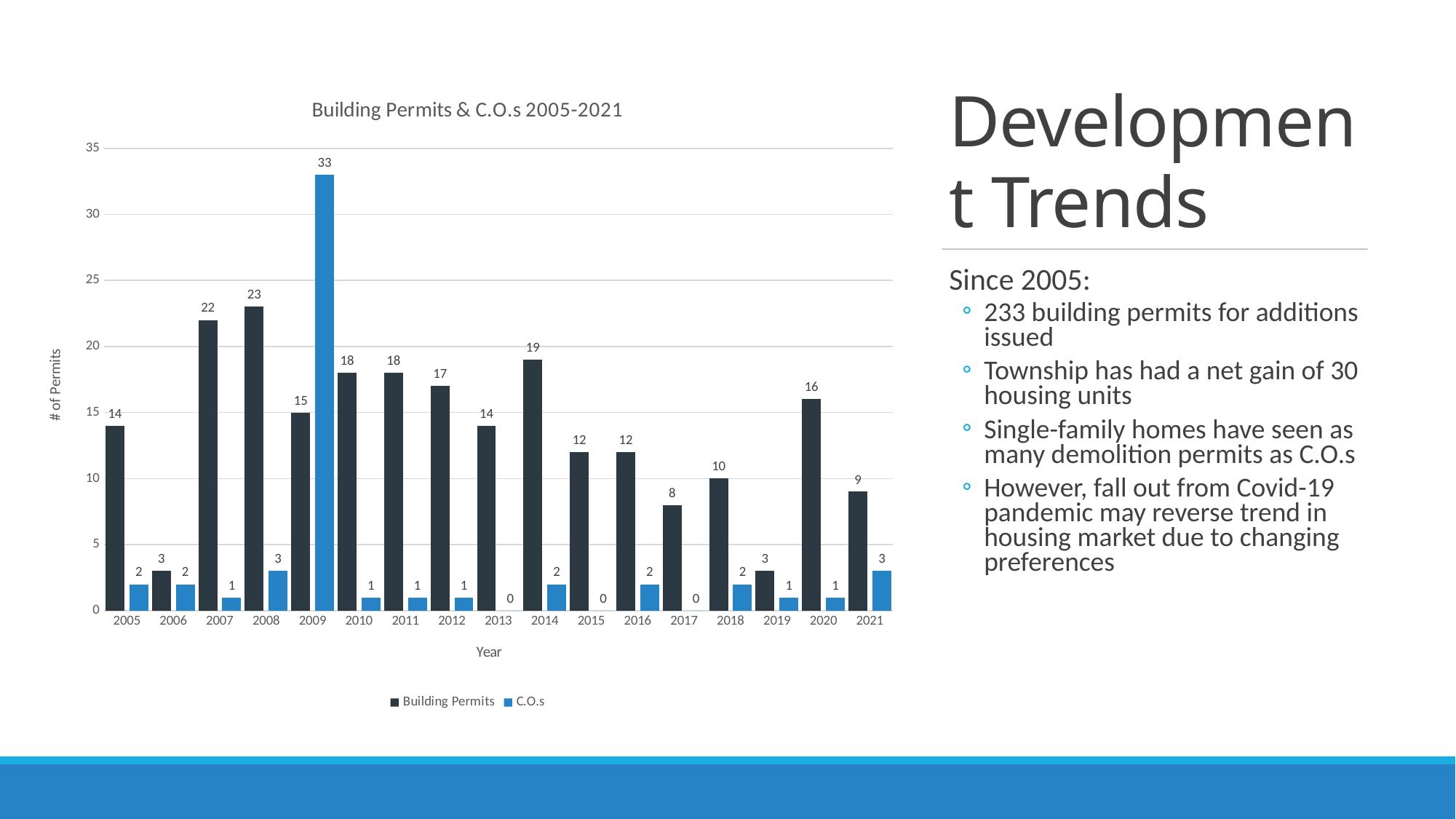
What is the value for C.O.s in 2021? 3 Which is larger: Building Permits in 2014 or Building Permits in 2010? Building Permits in 2014 Which year has the highest number of Building Permits? 2008 What is the difference between Building Permits in 2007 and Building Permits in 2017? 14 What is the value for C.O.s in 2009? 33 What kind of chart is shown? Bar chart How many series does the legend list? 2 Which year has the highest number of C.O.s? 2009 What is the value for Building Permits in 2020? 16 How many years are shown on the x axis? 17 What is the value for Building Permits in 2008? 23 What is the title of the chart? Building Permits & C.O.s 2005-2021